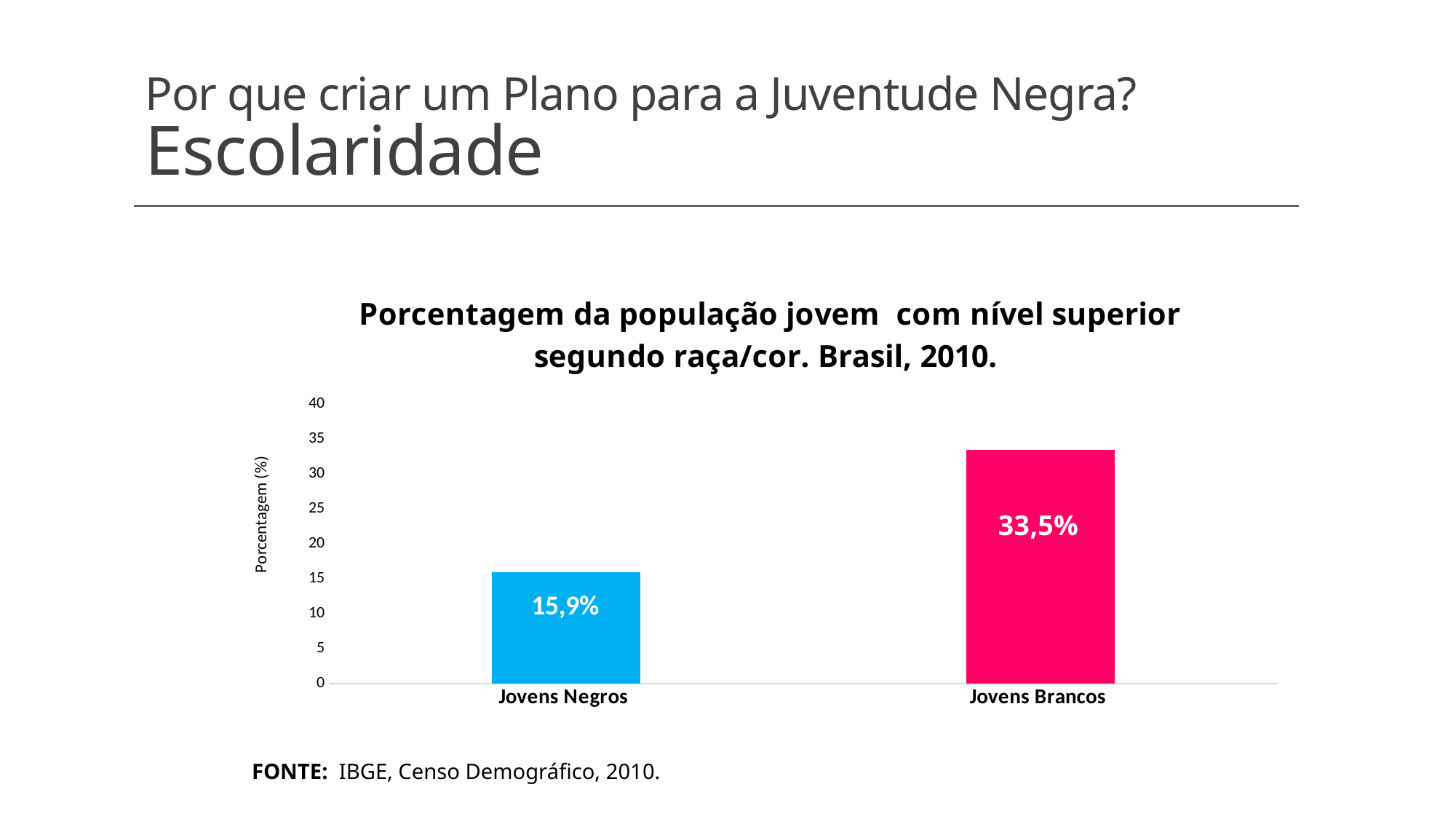
Which category has the highest value? Jovens Brancos What is the value for Jovens Brancos? 33,5% What kind of chart is shown on the slide? Bar chart Which category has the lowest value? Jovens Negros What is the difference between the values for Jovens Brancos and Jovens Negros? 17,6% What is the value for Jovens Negros? 15,9% How many categories are shown in the chart? 2 Is the value for Jovens Brancos greater or less than 30? greater Which is larger, the value for Jovens Negros or the value for Jovens Brancos? Jovens Brancos Is the value for Jovens Negros greater or less than 20? less What is the label of the vertical axis? Porcentagem (%) What is the title of the chart? Porcentagem da população jovem com nível superior segundo raça/cor. Brasil, 2010.